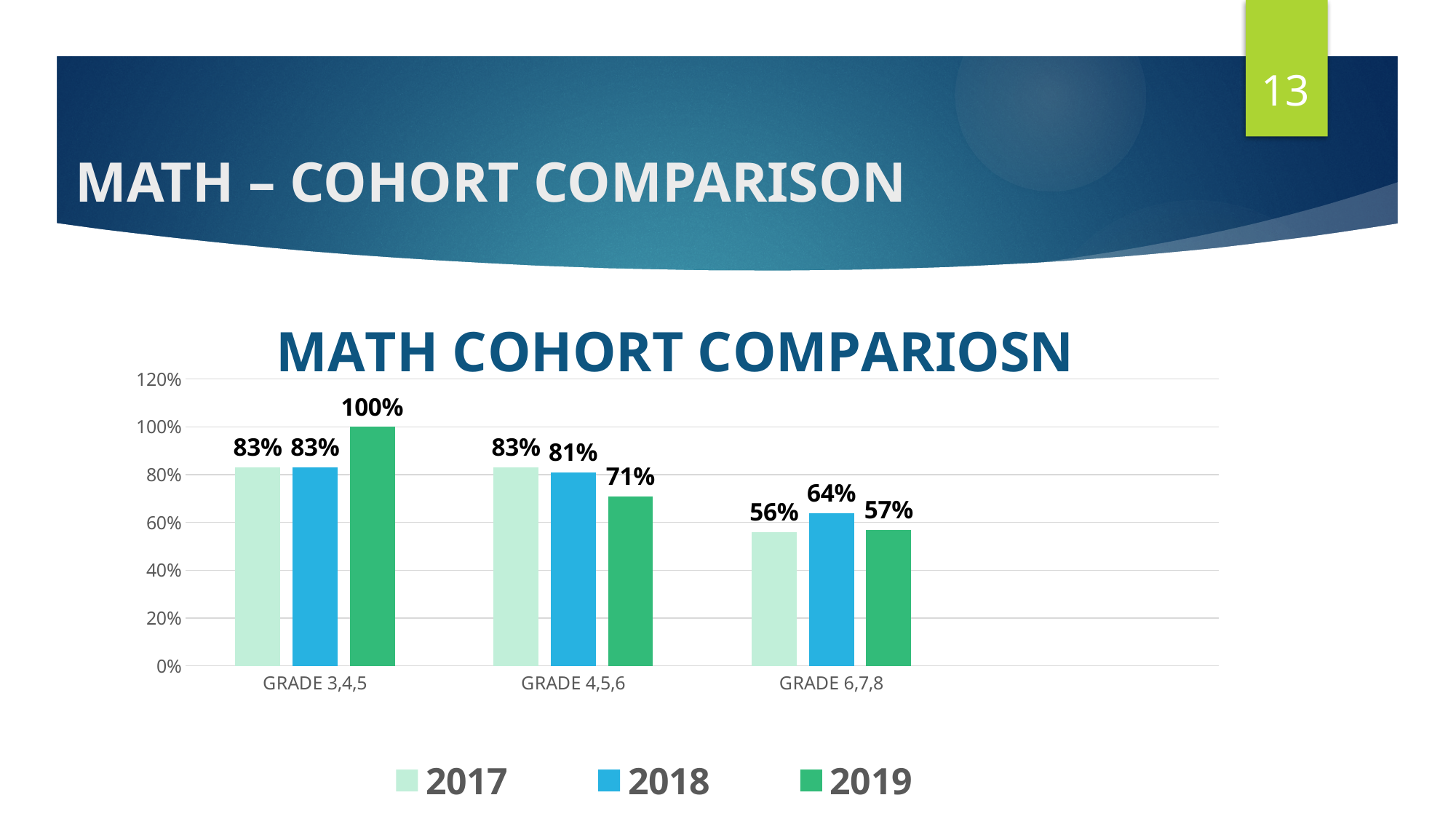
What is the value for 2018 in the GRADE 6,7,8 category? 64% How many categories are shown on the x axis? 3 What is the title of the chart? MATH COHORT COMPARIOSN How many series does the legend list? 3 What kind of chart is shown on the slide? Bar chart Which category has the highest value for the 2019 series? GRADE 3,4,5 Which category has the lowest value for the 2017 series? GRADE 6,7,8 What is the value for 2019 in the GRADE 3,4,5 category? 100% Which is larger in the GRADE 6,7,8 category: the 2018 value or the 2019 value? 2018 What is the difference between the 2019 values for GRADE 3,4,5 and GRADE 4,5,6? 29% What is the value for 2017 in the GRADE 4,5,6 category? 83% Do the 2019 values rise or fall from GRADE 3,4,5 to GRADE 6,7,8? Fall